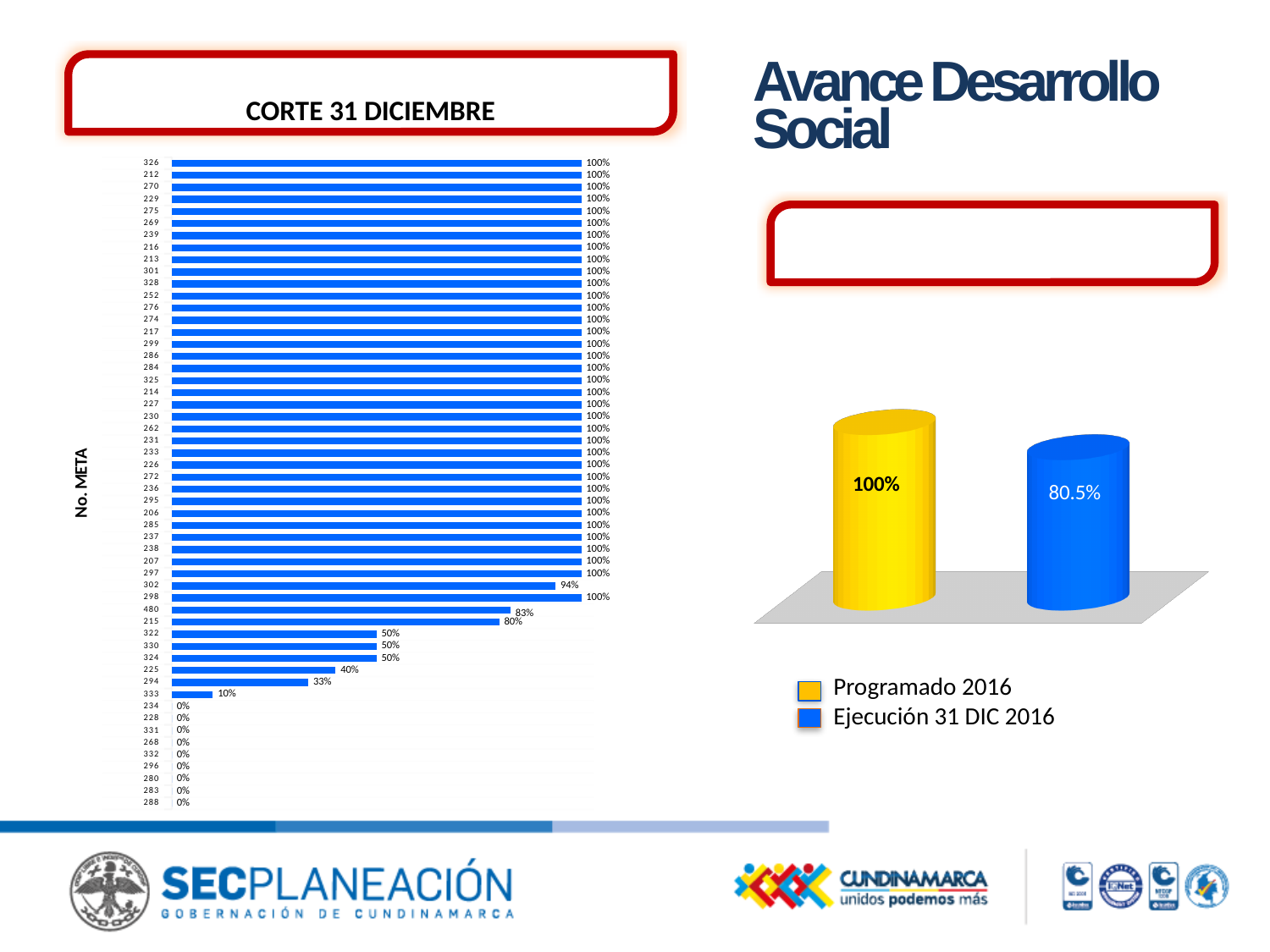
In the CORTE 31 DICIEMBRE chart on the left, what is the value for meta 225? 40% How many series does the legend of the Avance Desarrollo Social chart on the right list? 2 In the Avance Desarrollo Social chart on the right, what is the value for Ejecución 31 DIC 2016? 80.5% In the CORTE 31 DICIEMBRE chart on the left, what is the value for meta 480? 83% In the CORTE 31 DICIEMBRE chart on the left, how many metas show a value of 0%? 9 In the CORTE 31 DICIEMBRE chart on the left, what is the value for meta 333? 10% What kind of chart is the CORTE 31 DICIEMBRE chart on the left? Bar chart In the CORTE 31 DICIEMBRE chart on the left, what is the value for meta 302? 94% In the CORTE 31 DICIEMBRE chart on the left, what is the value for meta 215? 80% In the CORTE 31 DICIEMBRE chart on the left, which has the larger value, meta 225 or meta 294? Meta 225 In the CORTE 31 DICIEMBRE chart on the left, what is the difference between the values for meta 302 and meta 480? 11 percentage points In the Avance Desarrollo Social chart on the right, what is the difference between Programado 2016 and Ejecución 31 DIC 2016? 19.5 percentage points